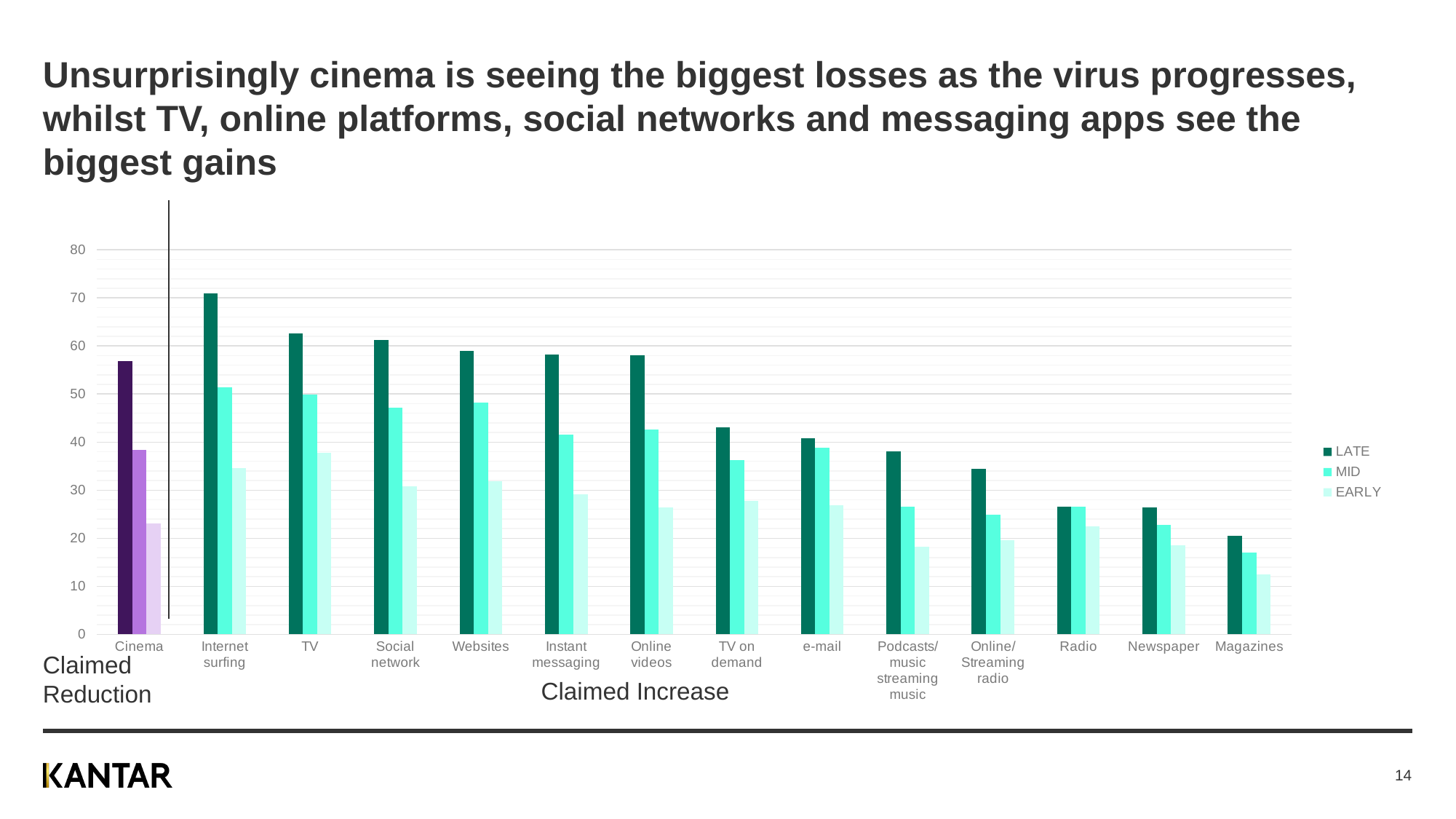
Which category has the highest EARLY value? TV How many categories are shown along the x axis? 14 How many series does the legend list? 3 Which is larger, the LATE value for Internet surfing or the LATE value for TV? Internet surfing Do the LATE values rise or fall moving from Internet surfing to Magazines along the x axis? fall Which category is placed under the 'Claimed Reduction' label? Cinema Is the EARLY value for Magazines greater or less than 20? less Is the LATE value for Internet surfing greater or less than 60? greater Which category has the highest LATE value? Internet surfing Which category has the lowest LATE value? Magazines What kind of chart is shown on the slide? bar chart Is the LATE value for Cinema greater or less than 50? greater